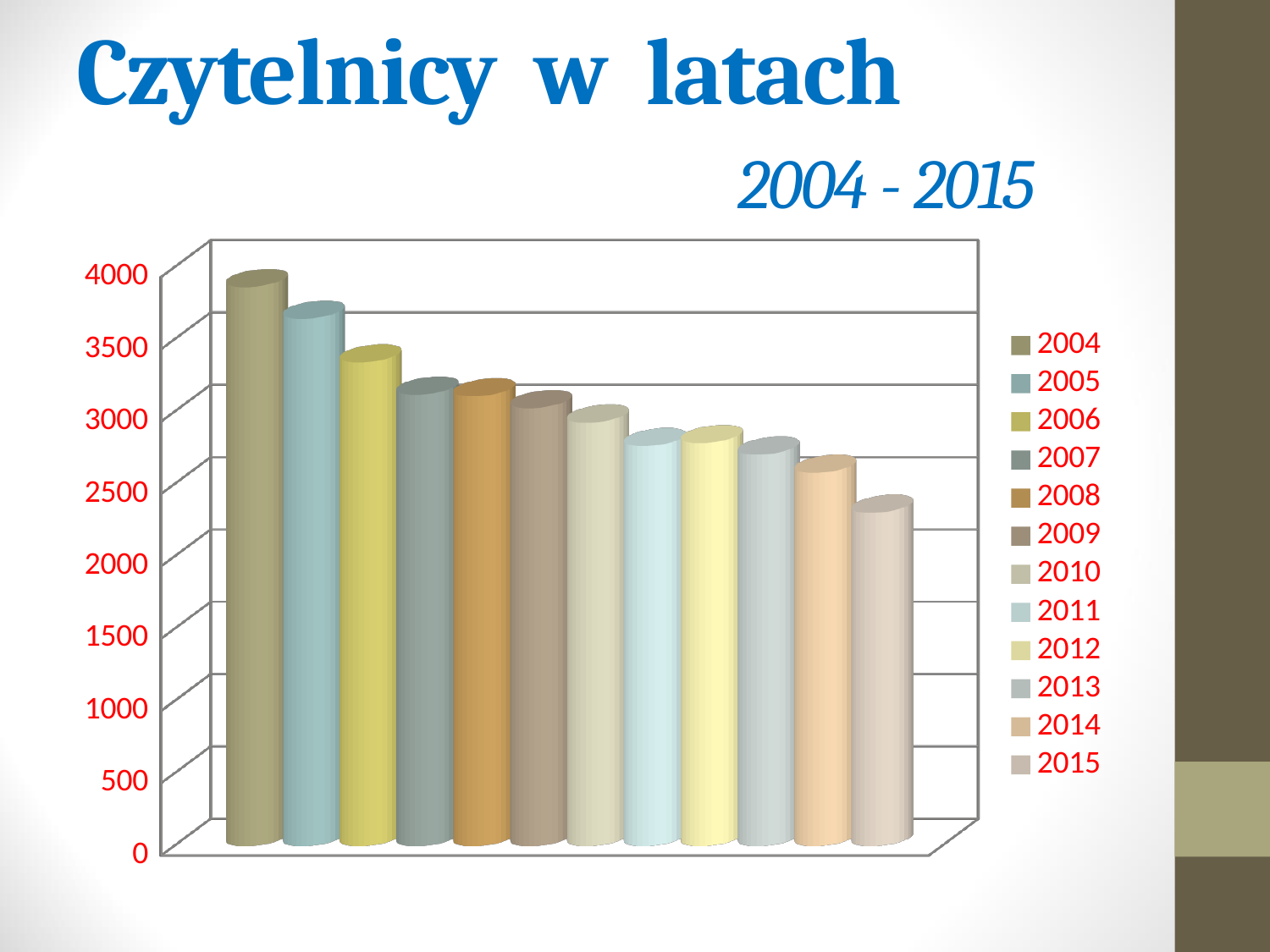
Do the values generally rise or fall from 2004 to 2015? fall Is the value for 2006 greater or less than 3000? greater Is the value for 2011 greater or less than 3000? less What kind of chart is shown on the slide? bar chart Which is larger, the value for 2006 or the value for 2013? 2006 Which year has the lowest value in the chart? 2015 Which year has the highest value in the chart? 2004 How many entries does the legend list? 12 Is the value for 2004 greater or less than 3500? greater How many bars are plotted in the chart? 12 What is the title of the slide containing the chart? Czytelnicy w latach 2004 - 2015